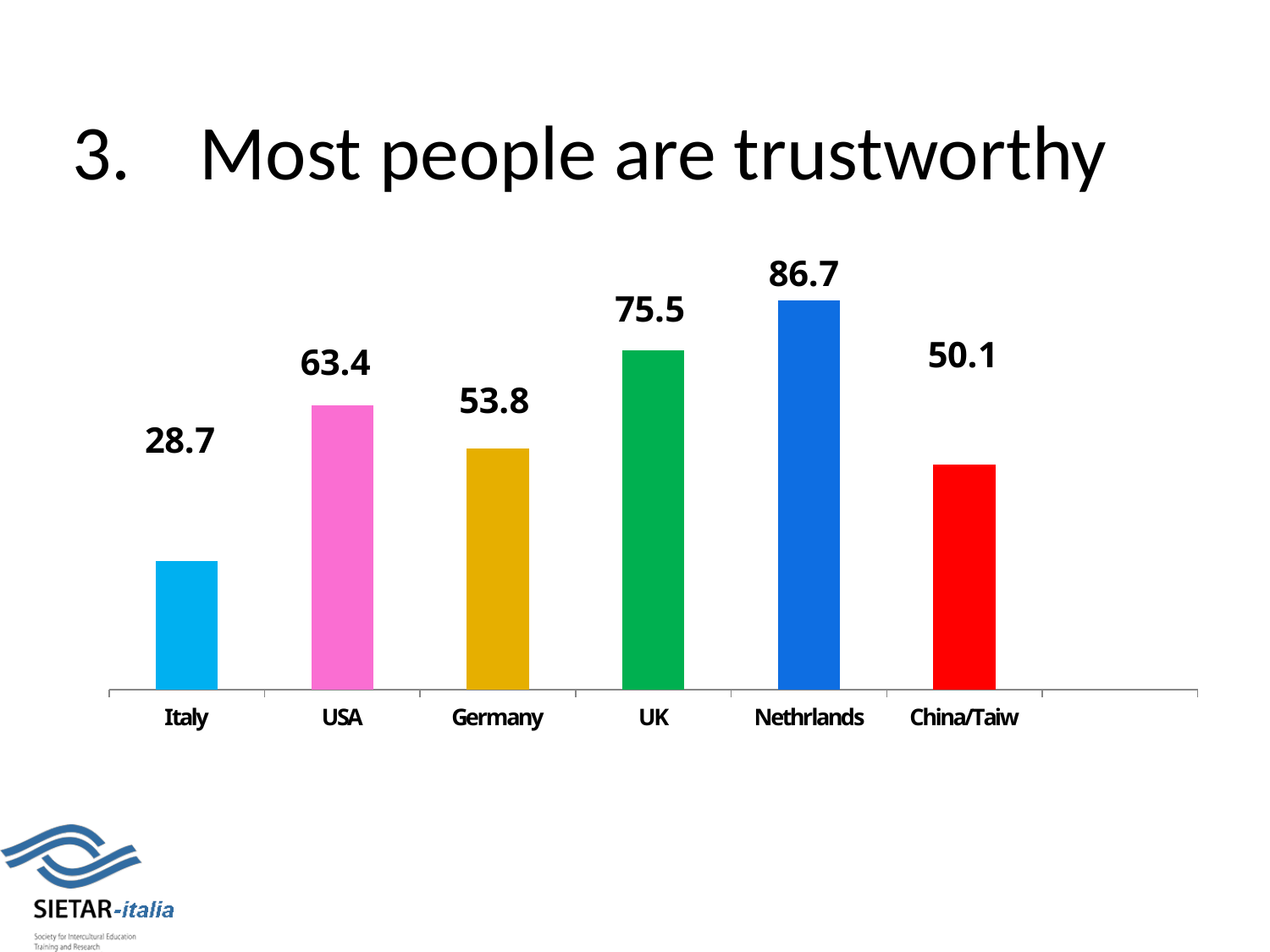
What kind of chart is shown on the slide? bar chart What is the value for Italy? 28.7 What is the value for China/Taiw? 50.1 Which category has the lowest value? Italy What is the difference between the values for USA and Italy? 34.7 How many categories are shown on the x axis? 6 What is the title of the slide? 3. Most people are trustworthy What is the value for Germany? 53.8 Which is larger, the value for USA or the value for Germany? USA Which category has the highest value? Nethrlands What colour is the bar for UK? green What is the difference between the values for Nethrlands and UK? 11.2